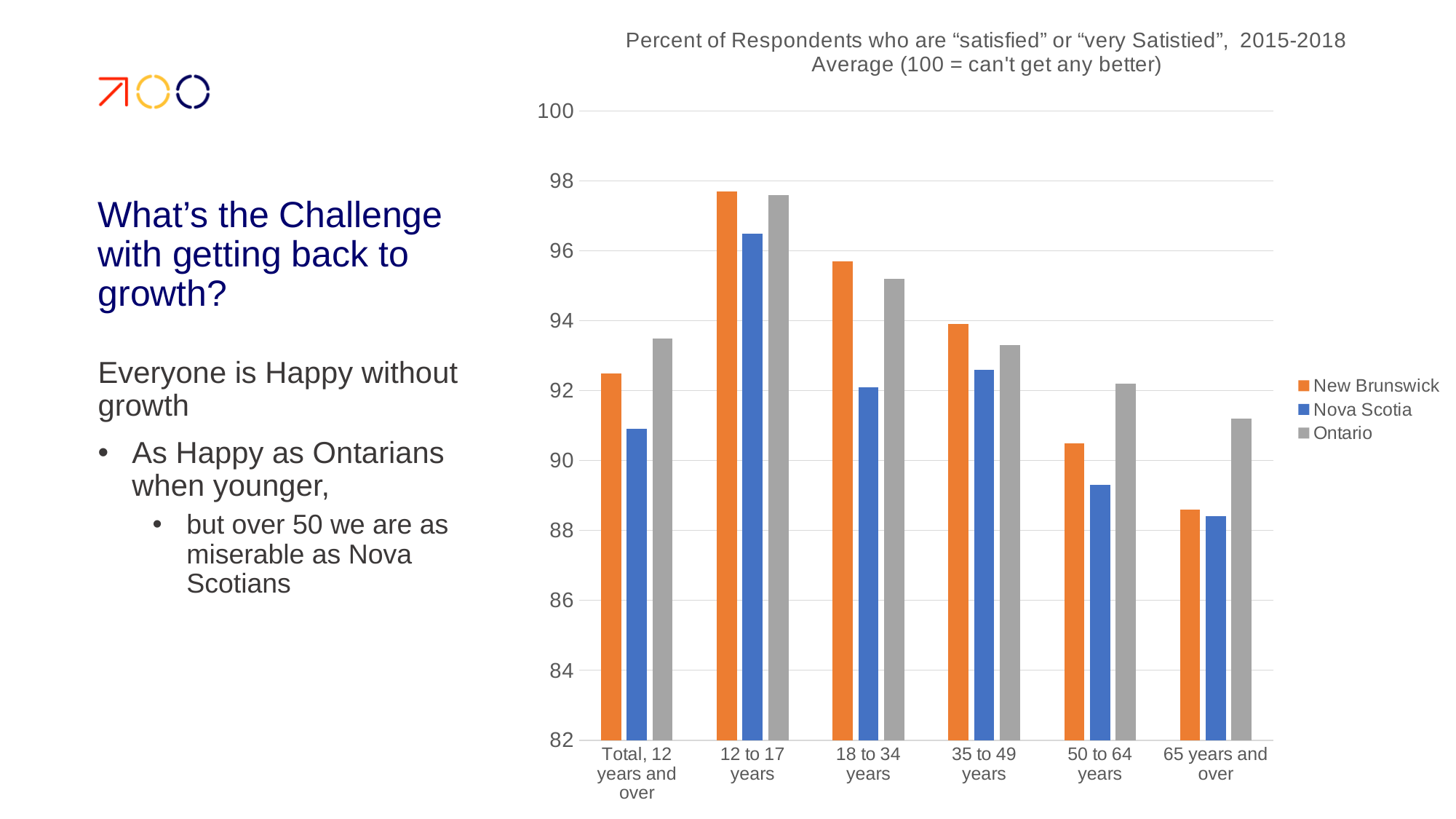
Is the value for Nova Scotia in the 50 to 64 years group greater or less than 90? less In the 50 to 64 years group, which is larger: the value for Ontario or for New Brunswick? Ontario Is the value for Ontario in the 18 to 34 years group greater or less than 94? greater How many series does the legend list? 3 In the 18 to 34 years group, which is larger: the value for New Brunswick or for Nova Scotia? New Brunswick Which age group has the highest value for Nova Scotia? 12 to 17 years How many age-group categories are shown on the x axis? 6 What colour represents Ontario in the legend? Grey Which age group has the lowest value for Ontario? 65 years and over From the 12 to 17 years group through the 65 years and over group, do the Nova Scotia values rise or fall? fall What kind of chart is shown on the slide? Bar chart Is the value for New Brunswick in the 65 years and over group greater or less than 90? less